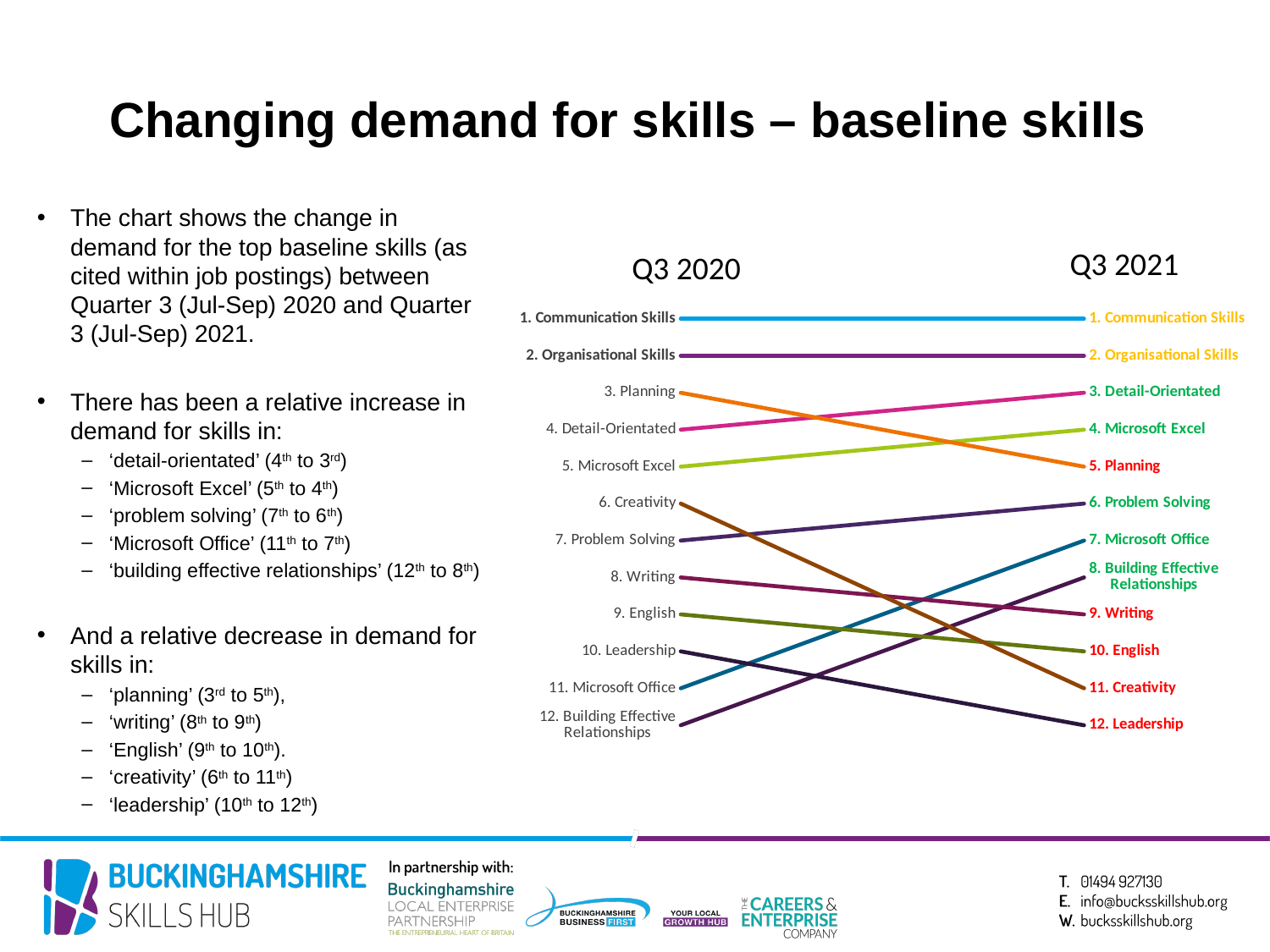
What rank did Writing hold in Q3 2021? 9 Which two time periods does the chart compare? Q3 2020 and Q3 2021 What rank did Microsoft Excel hold in Q3 2020? 5 What rank did Microsoft Office hold in Q3 2021? 7 Which skill is ranked 1st in both Q3 2020 and Q3 2021? Communication Skills Which skill is ranked 12th in Q3 2020? Building Effective Relationships Did Planning move up or down in rank from Q3 2020 to Q3 2021? Down How many skills are ranked in the chart? 12 Which skill is ranked 12th in Q3 2021? Leadership What kind of chart is shown on the slide? Line (slope) chart By how many places did Creativity fall between Q3 2020 and Q3 2021? 5 By how many places did Microsoft Office rise between Q3 2020 and Q3 2021? 4